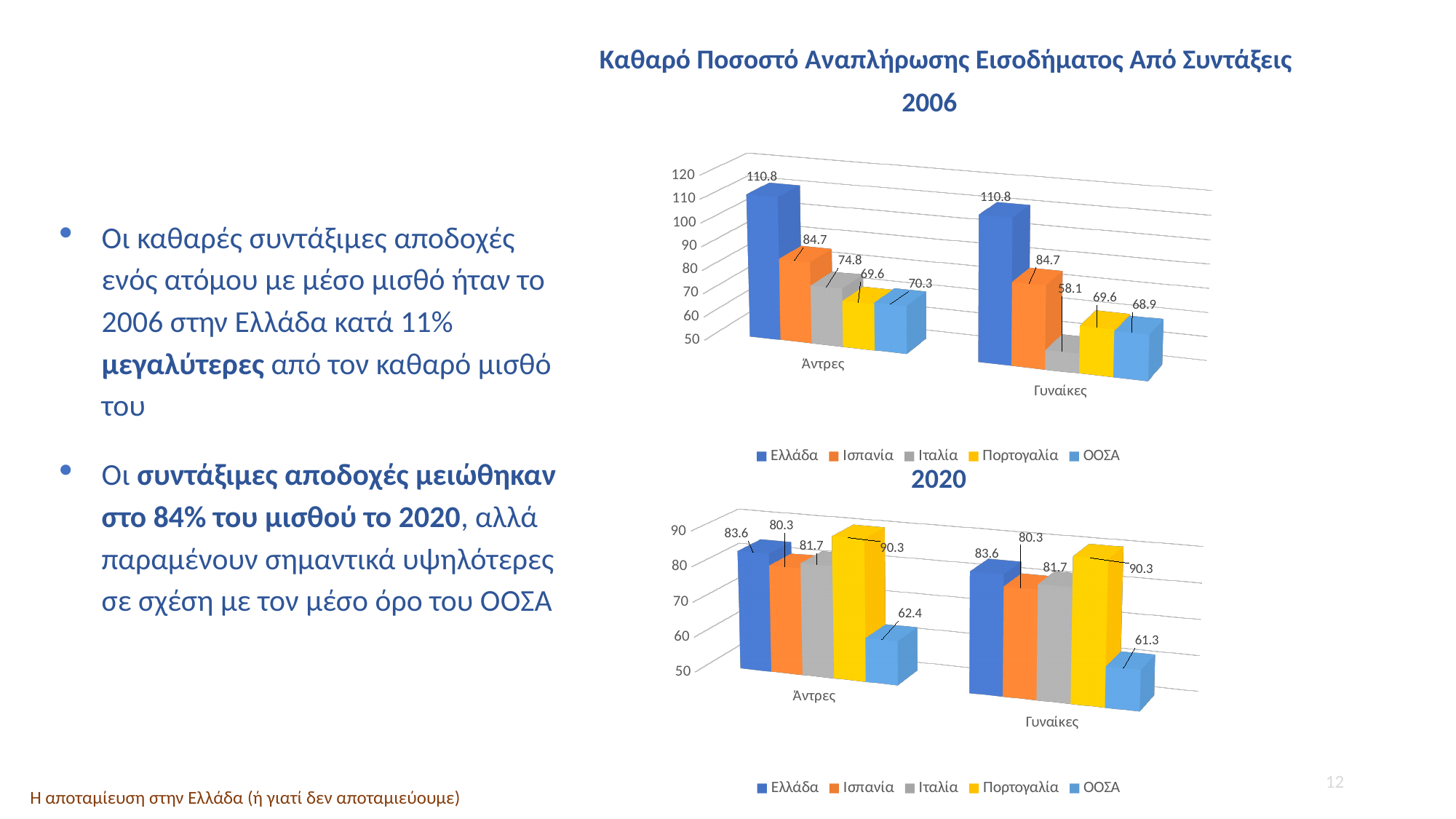
What type of chart is the 2020 chart? Bar chart In the 2020 chart, what is the difference between the Ελλάδα and ΟΟΣΑ values for Άντρες? 21.2 In the 2020 chart, how many categories are shown on the x axis? 2 In the 2006 chart, what is the value for Ελλάδα for Άντρες? 110.8 In the 2020 chart, what is the value for ΟΟΣΑ for Γυναίκες? 61.3 In the 2006 chart, what is the difference between the Ελλάδα and ΟΟΣΑ values for Άντρες? 40.5 In the 2006 chart, how many series does the legend list? 5 In the 2006 chart, what is the value for Ιταλία for Γυναίκες? 58.1 In the 2020 chart, which series has the highest value for Γυναίκες? Πορτογαλία In the 2020 chart, which is larger for Άντρες: Ελλάδα or Ισπανία? Ελλάδα In the 2020 chart, what is the value for Πορτογαλία for Άντρες? 90.3 In the 2006 chart, which series has the lowest value for Γυναίκες? Ιταλία